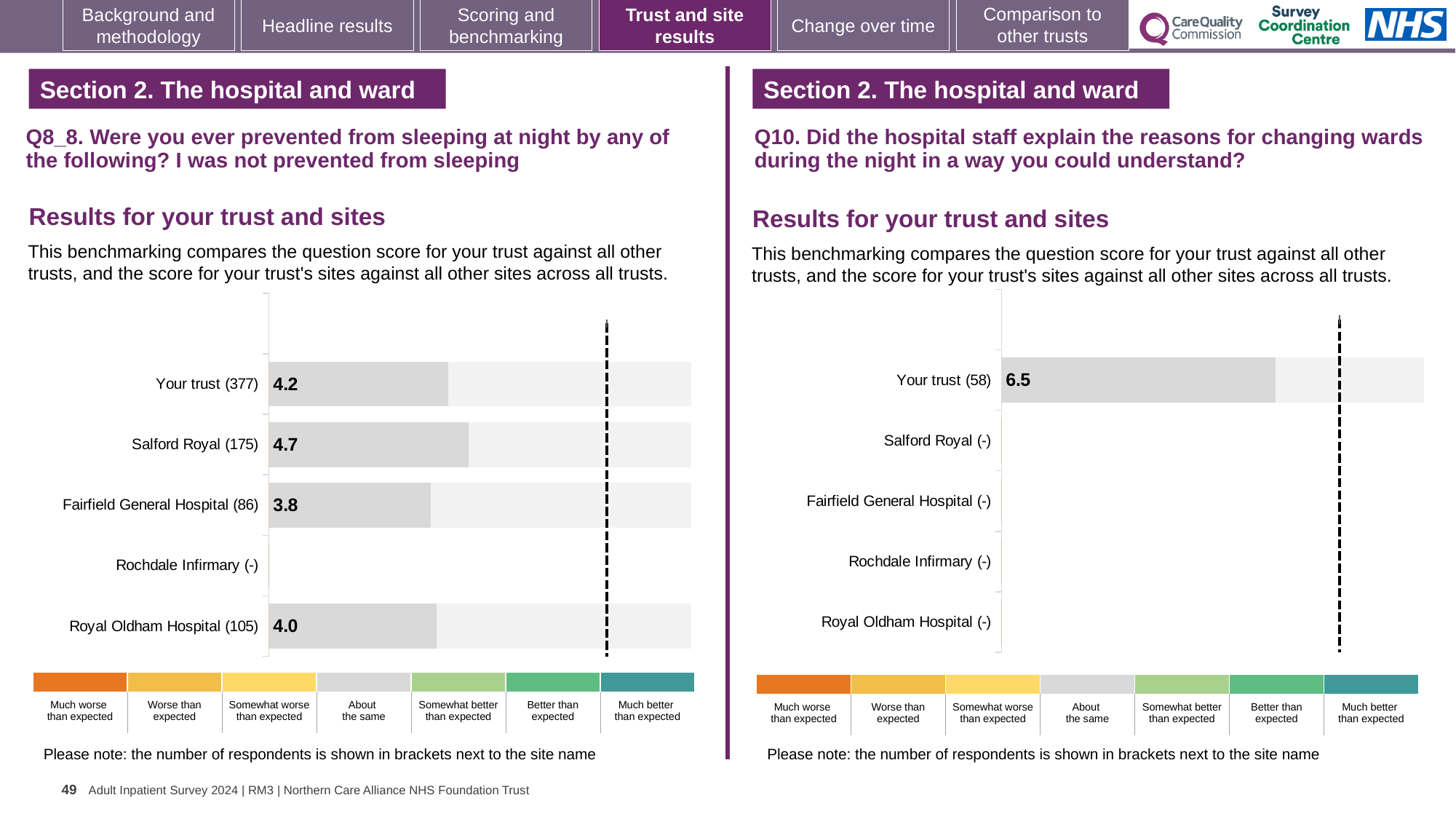
On the left chart (Q8_8), what is the score for Your trust? 4.2 On the left chart (Q8_8), which site with a printed score has the lowest score? Fairfield General Hospital On the right chart (Q10), what is the score for Your trust? 6.5 How many site rows (including Your trust) are listed on the left chart (Q8_8)? 5 On the left chart (Q8_8), what is the score for Salford Royal? 4.7 On the left chart (Q8_8), what is the score for Fairfield General Hospital? 3.8 On the left chart (Q8_8), which site has the highest score? Salford Royal What type of chart is used on the left (Q8_8)? Bar chart On the left chart (Q8_8), which has the larger score, Your trust or Royal Oldham Hospital? Your trust On the left chart (Q8_8), how many respondents are shown for Royal Oldham Hospital? 105 On the left chart (Q8_8), what is the difference between the scores for Salford Royal and Royal Oldham Hospital? 0.7 On the right chart (Q10), how many respondents are shown for Your trust? 58